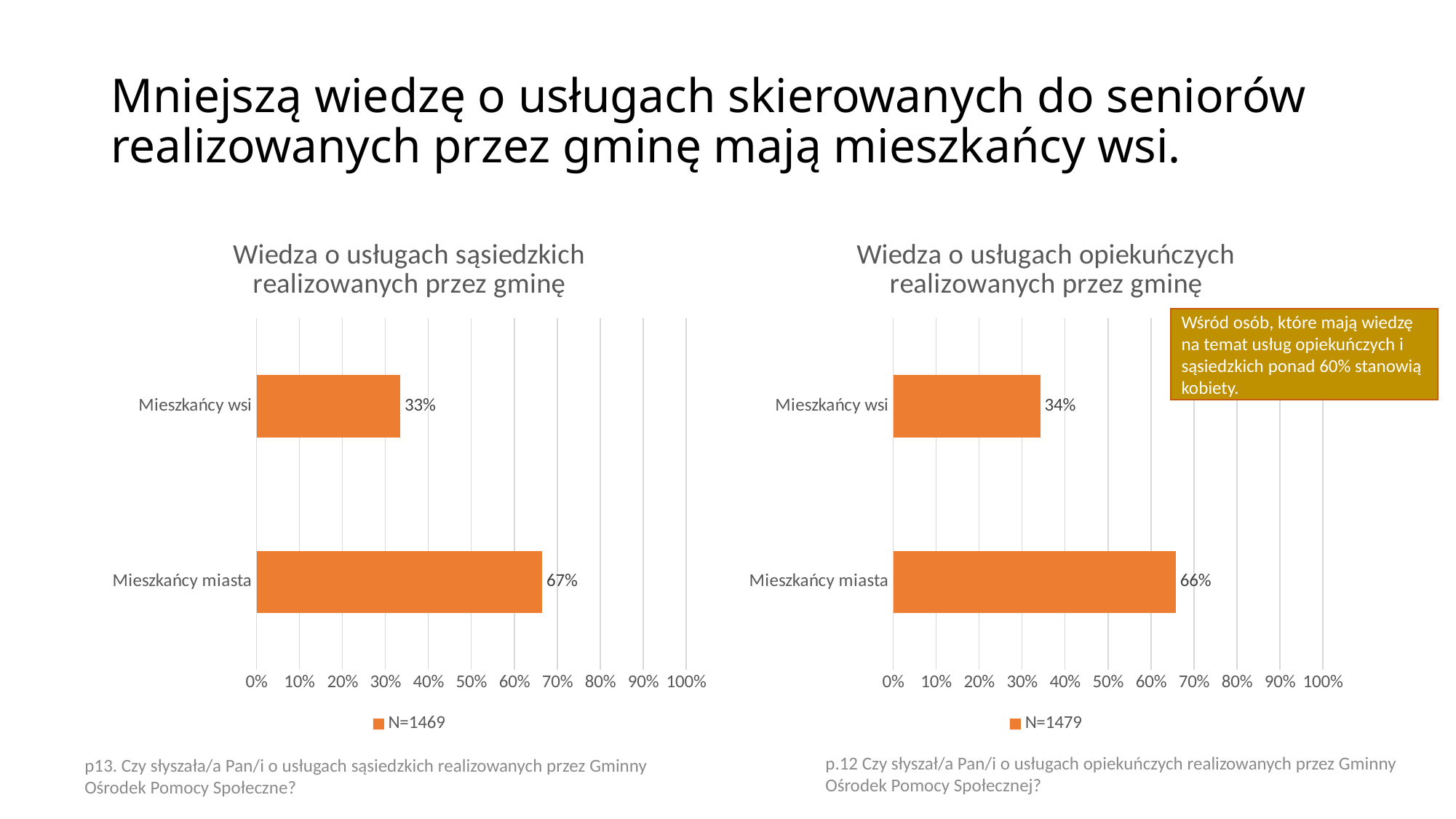
What legend entry is shown for the chart 'Wiedza o usługach sąsiedzkich realizowanych przez gminę'? N=1469 What kind of chart is 'Wiedza o usługach opiekuńczych realizowanych przez gminę'? Bar chart In the chart 'Wiedza o usługach opiekuńczych realizowanych przez gminę', which category has the lowest value? Mieszkańcy wsi In the chart 'Wiedza o usługach sąsiedzkich realizowanych przez gminę', which category has the highest value? Mieszkańcy miasta In the chart 'Wiedza o usługach opiekuńczych realizowanych przez gminę', which is larger: Mieszkańcy wsi or Mieszkańcy miasta? Mieszkańcy miasta In the chart 'Wiedza o usługach opiekuńczych realizowanych przez gminę', what is the value for Mieszkańcy miasta? 66% How many categories are shown in the chart 'Wiedza o usługach sąsiedzkich realizowanych przez gminę'? 2 In the chart 'Wiedza o usługach opiekuńczych realizowanych przez gminę', what is the difference between Mieszkańcy miasta and Mieszkańcy wsi? 32% In the chart 'Wiedza o usługach sąsiedzkich realizowanych przez gminę', what is the value for Mieszkańcy miasta? 67% In the chart 'Wiedza o usługach sąsiedzkich realizowanych przez gminę', what is the value for Mieszkańcy wsi? 33% In the chart 'Wiedza o usługach opiekuńczych realizowanych przez gminę', what is the value for Mieszkańcy wsi? 34% In the chart 'Wiedza o usługach sąsiedzkich realizowanych przez gminę', what is the difference between Mieszkańcy miasta and Mieszkańcy wsi? 34%